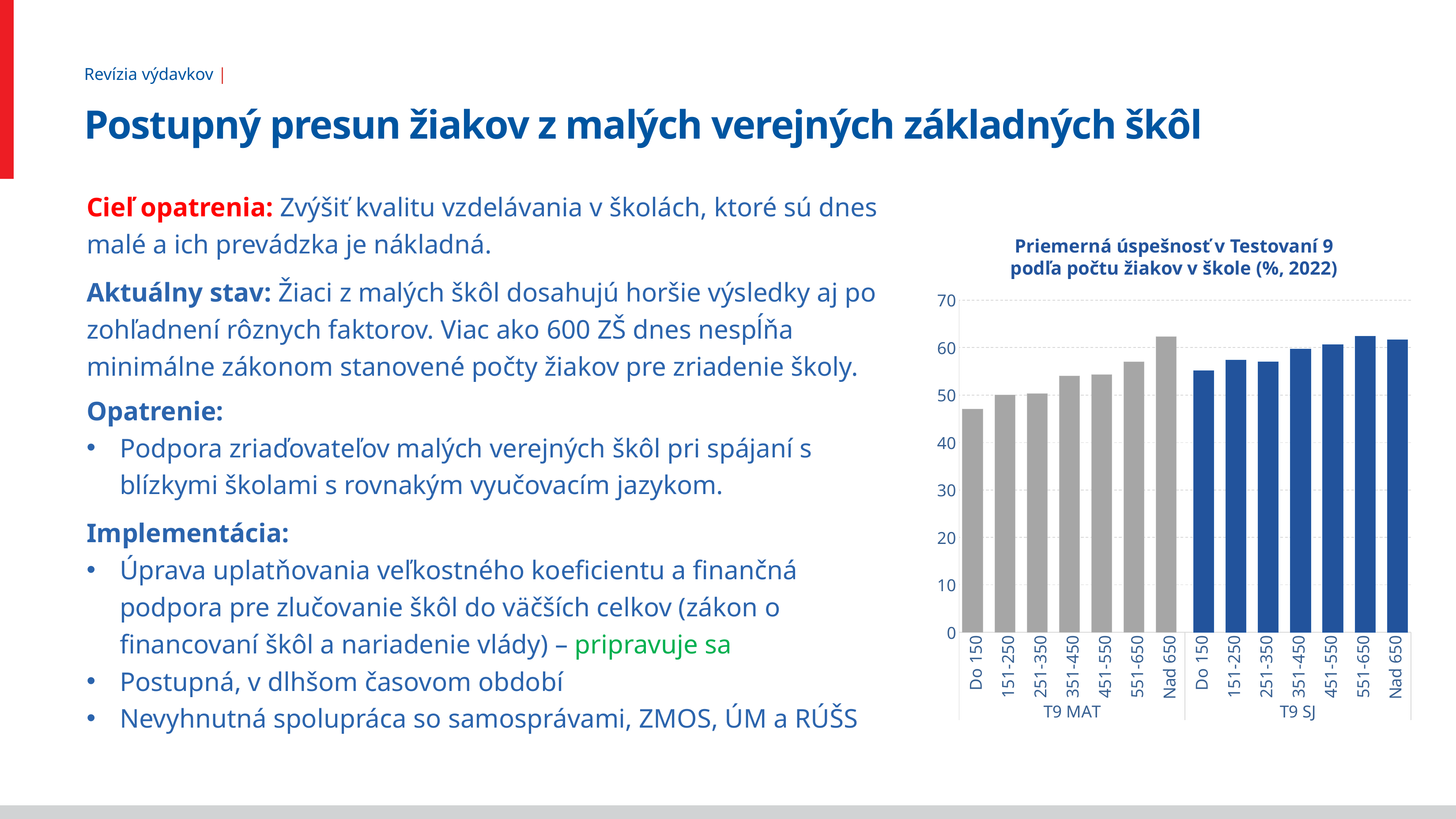
What is the title of the chart? Priemerná úspešnosť v Testovaní 9 podľa počtu žiakov v škole (%, 2022) Do the values in the T9 MAT group rise or fall as the school size increases from Do 150 to Nad 650? rise Which category has the highest value within the T9 MAT group? Nad 650 Which is larger: the value for Do 150 in T9 MAT or the value for Do 150 in T9 SJ? Do 150 in T9 SJ Is the value for Do 150 in the T9 MAT group greater or less than 50? less How many school-size categories are shown within the T9 MAT group? 7 Is the value for Do 150 in the T9 SJ group greater or less than 50? greater How many bars are plotted in the chart in total? 14 Is the value for Nad 650 in the T9 MAT group greater or less than 60? greater What kind of chart is shown on the slide? bar chart Which category has the lowest value in the whole chart? Do 150 (T9 MAT)